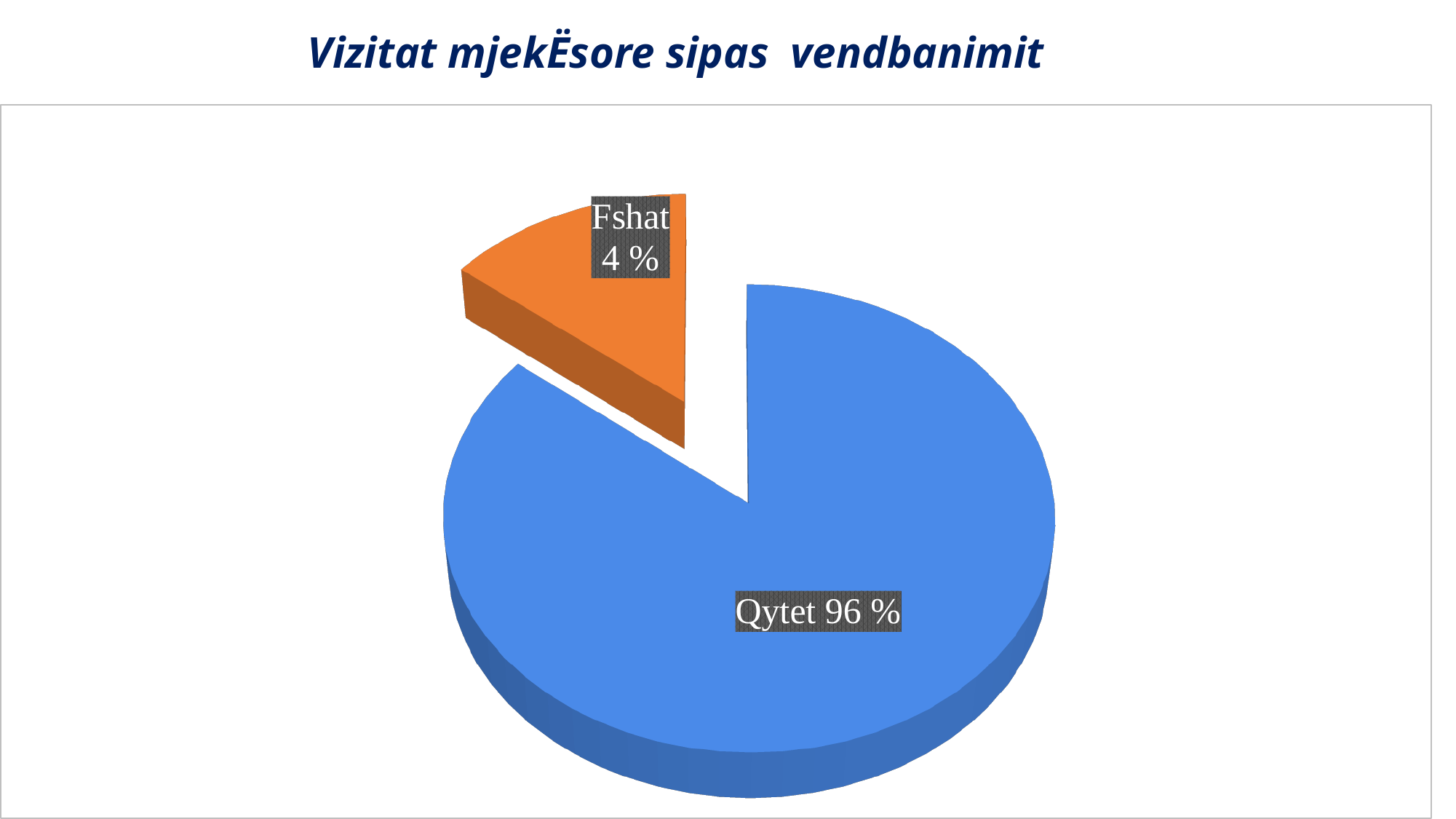
What is the difference between the Qytet and Fshat shares? 92 % What colour is the Fshat slice? Orange What is the value shown for Fshat? 4 % Which is larger, the share for Qytet or the share for Fshat? Qytet What is the title of the slide? Vizitat mjekËsore sipas vendbanimit What is the value shown for Qytet? 96 % Which category has the smallest share of the pie? Fshat What share of the pie does the Fshat slice represent? 4 % Which category has the largest share of the pie? Qytet What type of chart is shown on the slide? Pie chart How many slices does the pie chart have? 2